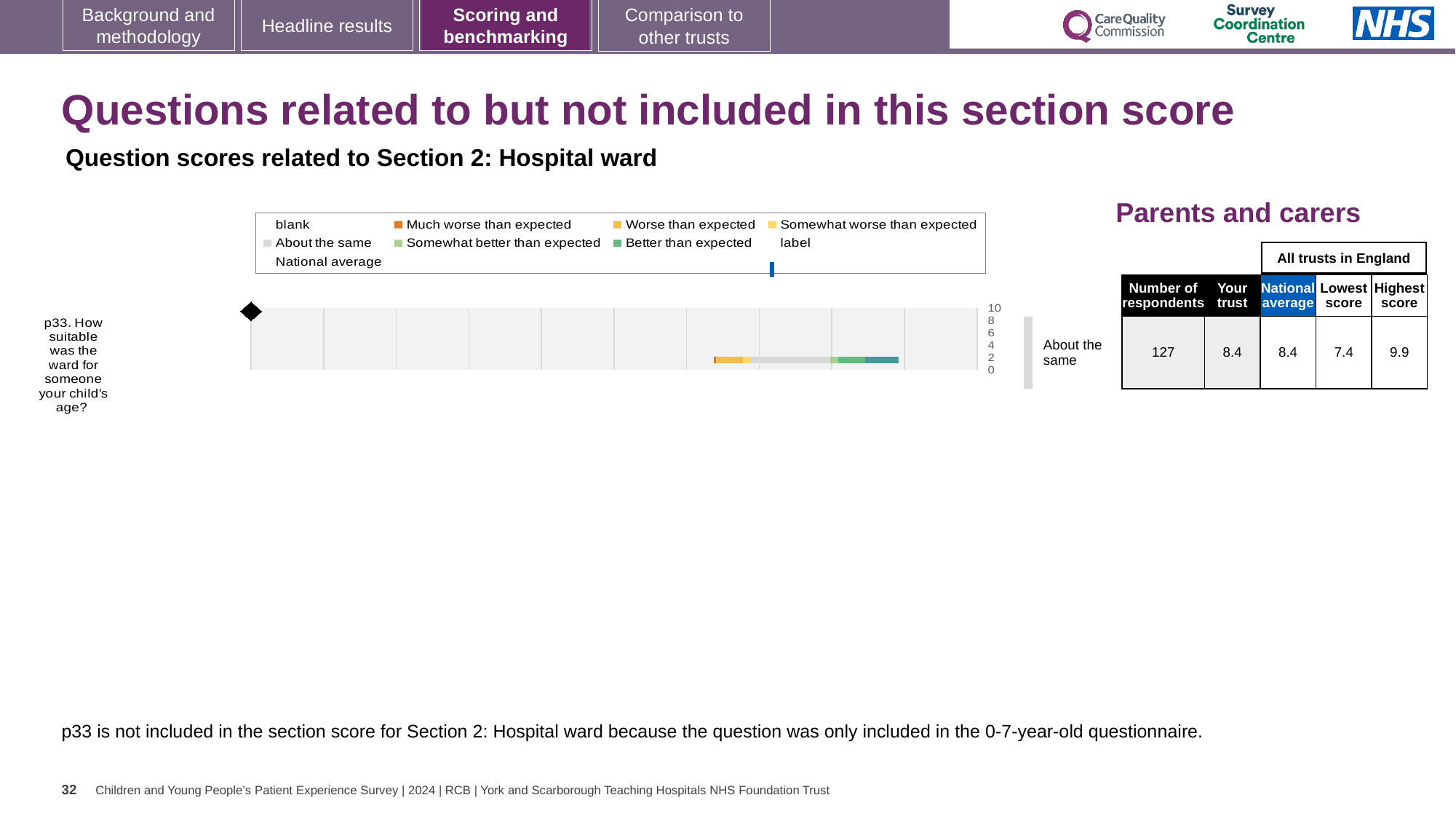
What is the highest value shown on the chart's axis? 10 Which question is plotted in the chart? p33. How suitable was the ward for someone your child's age? Which is larger for p33: the highest score among all trusts or the 'Your trust' score? Highest score How many questions are plotted in the chart? 1 What is the difference between the highest and lowest trust scores for p33? 2.5 What benchmark category label is shown next to the bar for p33? About the same What is the highest score among all trusts in England for p33? 9.9 What kind of chart is shown on the slide? bar chart What is the lowest score among all trusts in England for p33? 7.4 How many respondents answered p33? 127 What is the 'Your trust' score for p33 in the table beside the chart? 8.4 What is the national average score for p33 in the table beside the chart? 8.4